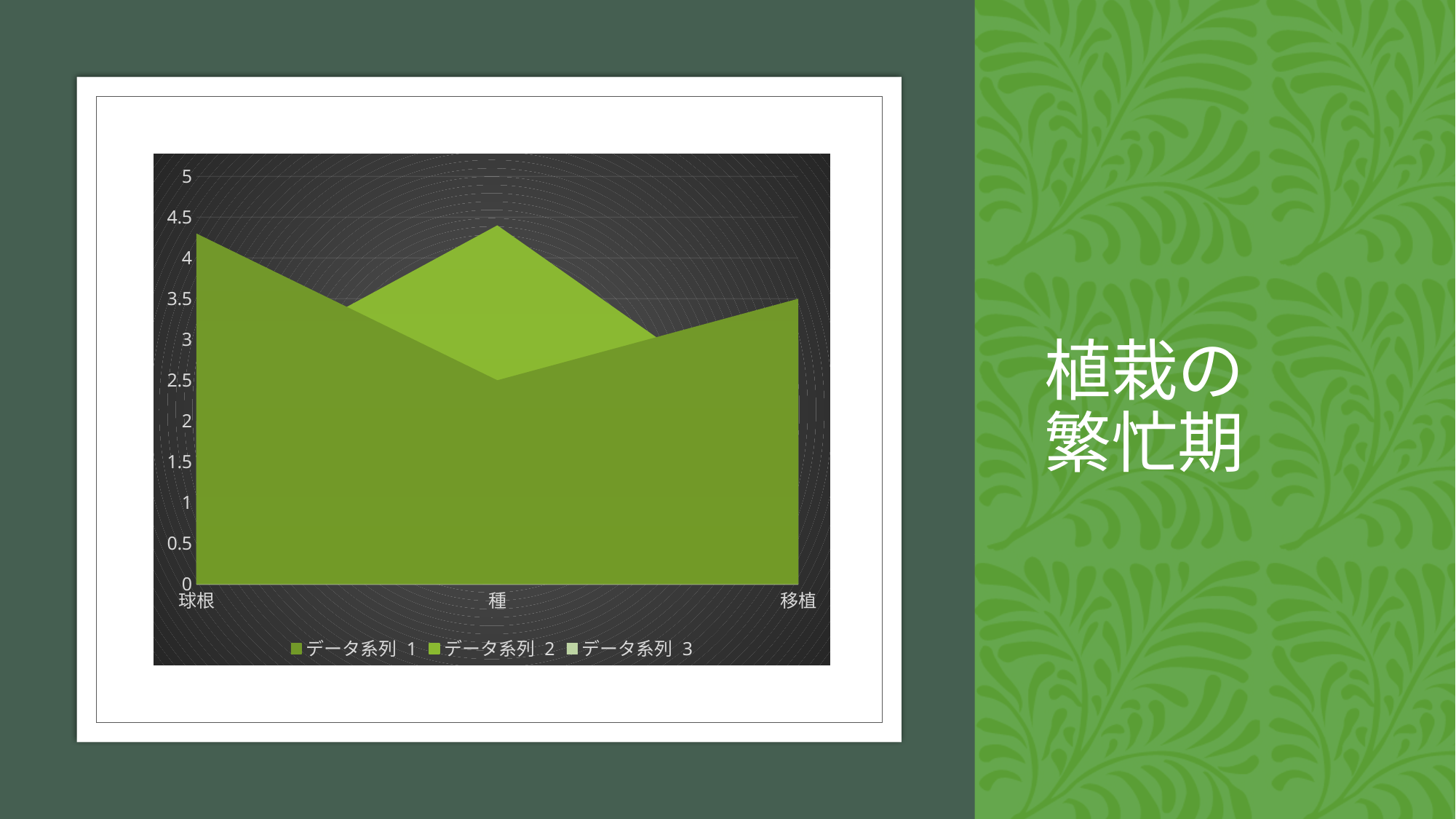
How many series does the chart's legend list? 3 How many categories are shown on the x axis of the chart? 3 Is the value of the darker green area at 移植 greater or less than 3? greater What kind of chart is shown on the slide? Area chart Is the value of the lighter green area at 移植 greater or less than 3.5? less For the darker green area, which category has the highest value? 球根 What are the three category labels on the x axis of the chart? 球根, 種, 移植 What is the name of the first series in the chart's legend? データ系列 1 Is the value of the darker green area at 種 greater or less than 3? less For the darker green area, which category has the lowest value? 種